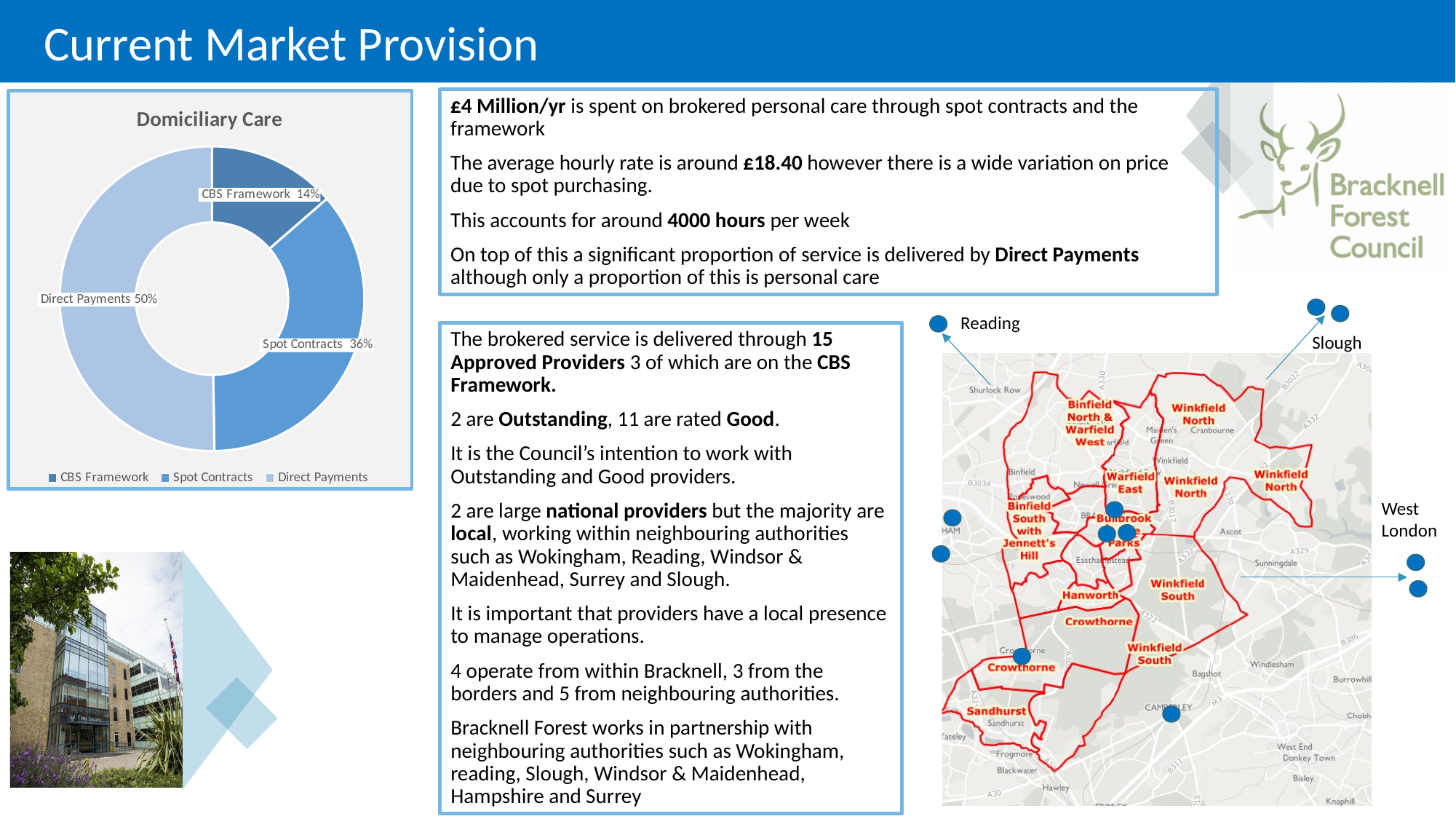
Which categories are listed in the legend of the Domiciliary Care chart? CBS Framework, Spot Contracts, Direct Payments What is the difference in percentage points between Spot Contracts and CBS Framework in the Domiciliary Care chart? 22 percentage points What share of the Domiciliary Care chart is Direct Payments? 50% What share of the Domiciliary Care chart is CBS Framework? 14% What is the difference in percentage points between Direct Payments and Spot Contracts in the Domiciliary Care chart? 14 percentage points Which category has the largest share in the Domiciliary Care chart? Direct Payments Which category has the smallest share in the Domiciliary Care chart? CBS Framework How many categories are shown in the Domiciliary Care chart? 3 Which is larger in the Domiciliary Care chart, Spot Contracts or CBS Framework? Spot Contracts What kind of chart is the Domiciliary Care chart? Doughnut (pie) chart What is the title of the chart on the slide? Domiciliary Care What share of the Domiciliary Care chart is Spot Contracts? 36%